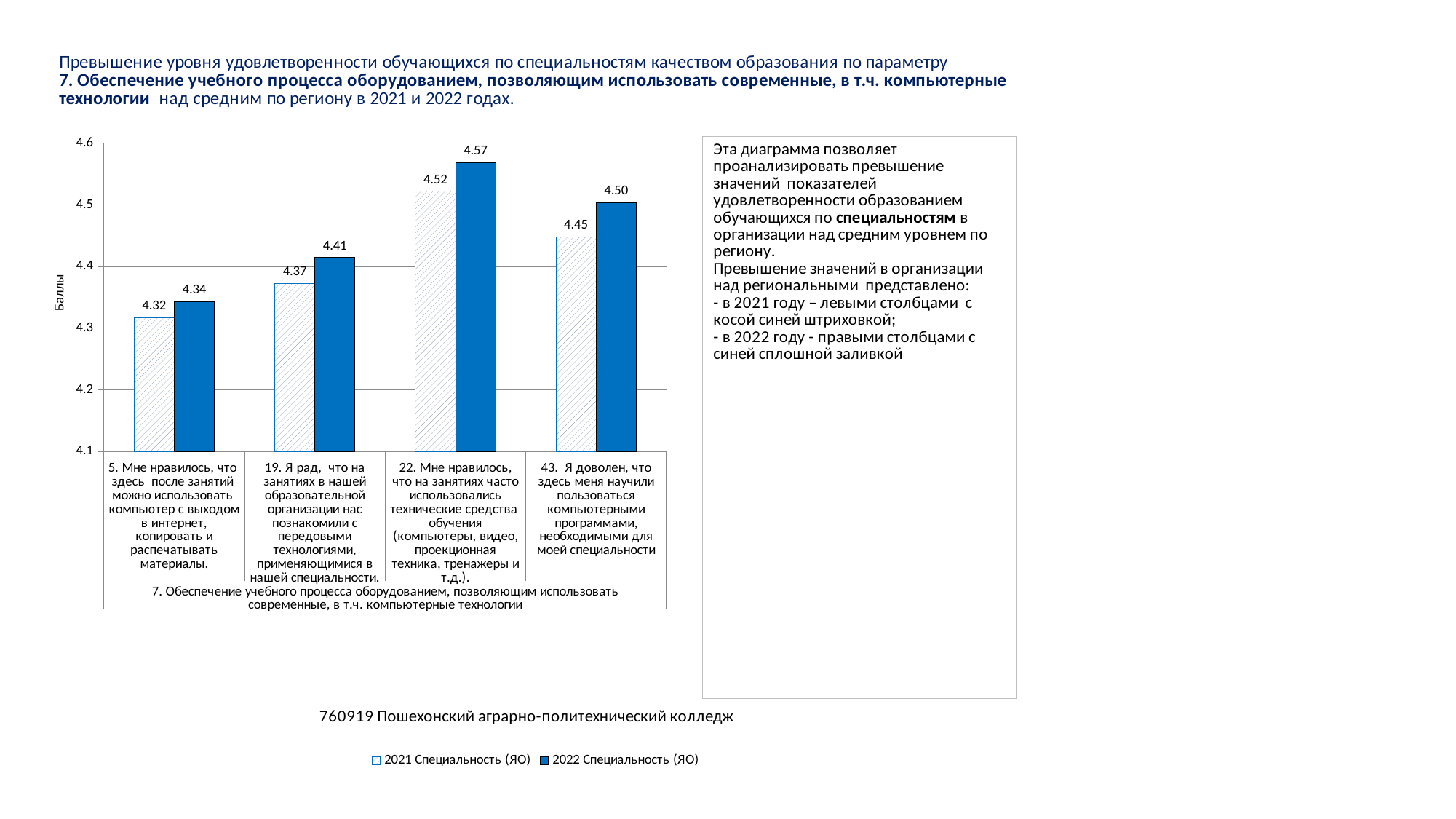
How many categories are shown on the x axis of the chart? 4 What is the value for "2021 Специальность (ЯО)" for category 5 (Мне нравилось, что здесь после занятий можно использовать компьютер с выходом в интернет)? 4.32 How many series does the legend list? 2 What is the value for "2021 Специальность (ЯО)" for category 43 (Я доволен, что здесь меня научили пользоваться компьютерными программами)? 4.45 Which category has the lowest value for "2021 Специальность (ЯО)"? 5. Мне нравилось, что здесь после занятий можно использовать компьютер с выходом в интернет What kind of chart is shown on the slide? Bar chart What is the difference between the 2022 and 2021 values for category 43 (Я доволен, что здесь меня научили пользоваться компьютерными программами)? 0.05 What is the value for "2022 Специальность (ЯО)" for category 22 (Мне нравилось, что на занятиях часто использовались технические средства обучения)? 4.57 Which is larger for category 19 (Я рад, что на занятиях в нашей образовательной организации нас познакомили с передовыми технологиями): the 2021 value or the 2022 value? 2022 value (4.41) Is the 2021 value for category 22 greater or less than 4.5? greater What is the label of the y axis of the chart? Баллы Which category has the highest value for "2022 Специальность (ЯО)"? 22. Мне нравилось, что на занятиях часто использовались технические средства обучения